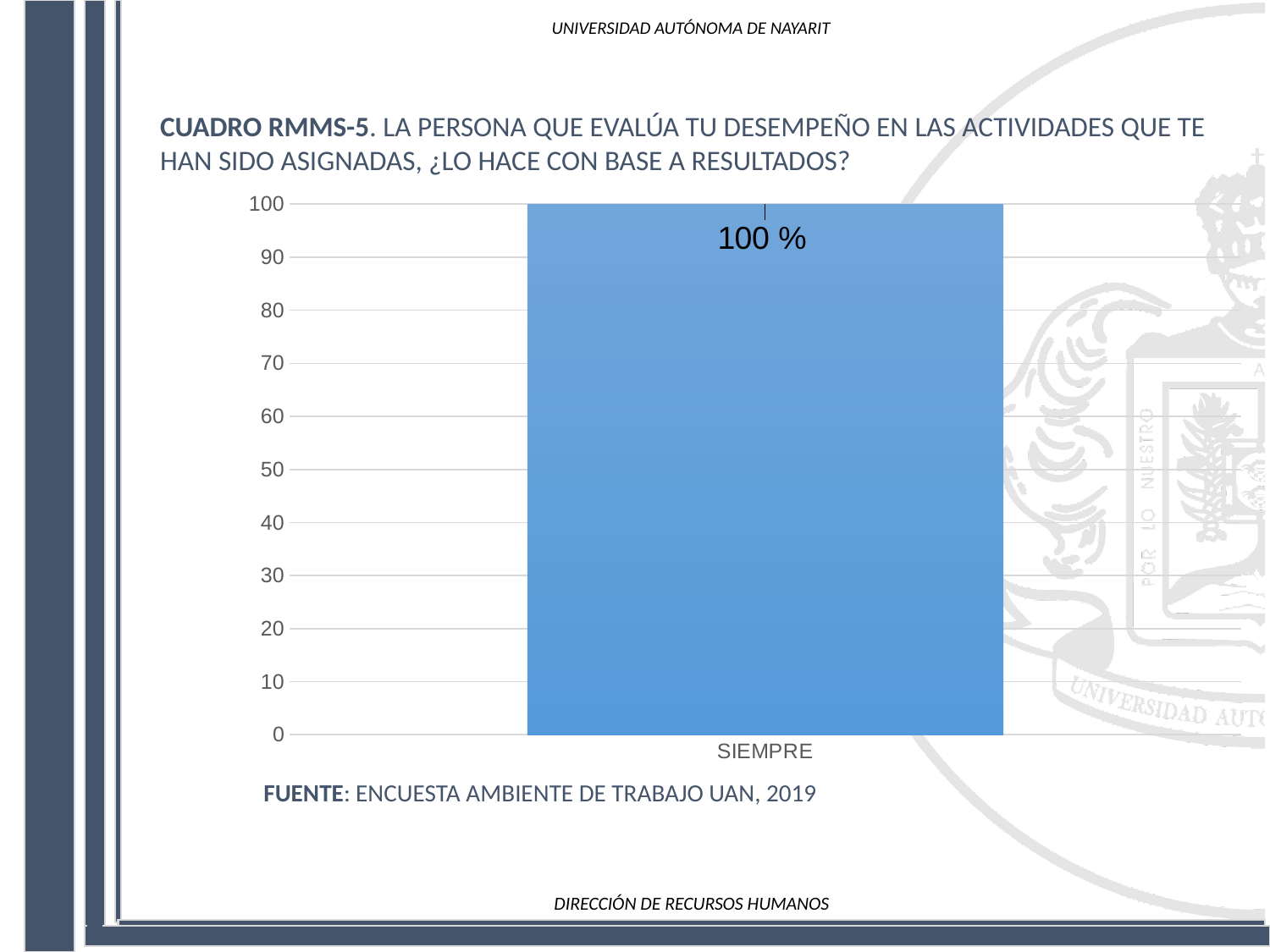
What is the highest value shown on the y axis? 100 What is the value for SIEMPRE? 100 % Is the value for SIEMPRE greater or less than 50? greater What kind of chart is shown on the slide? bar chart What is the label of the only category on the x axis? SIEMPRE How many categories are shown on the x axis? 1 Which category has the highest value? SIEMPRE